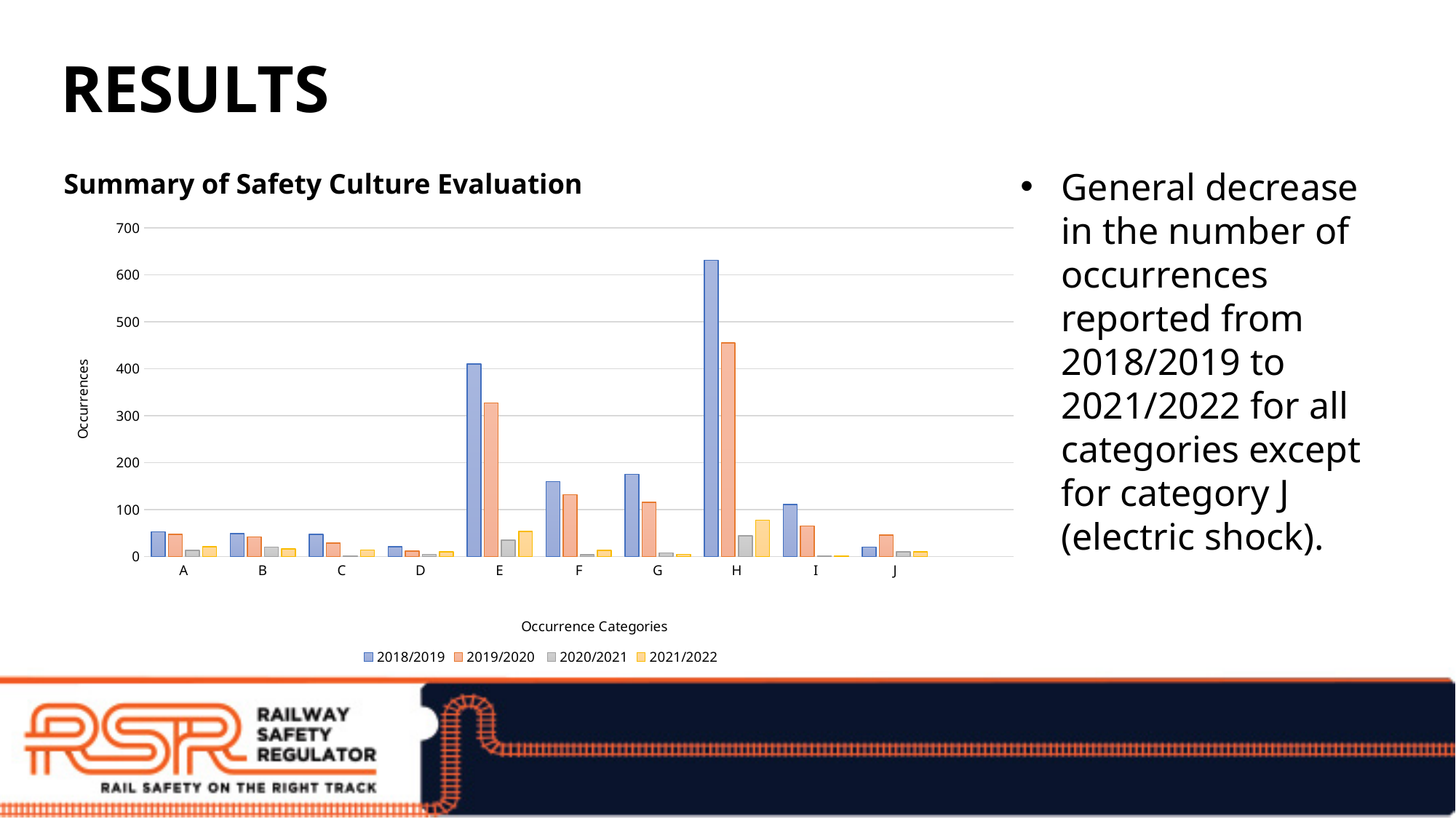
How many occurrence categories are shown on the x axis of the chart? 10 Which occurrence category has the highest value for 2021/2022? H In category J, which series has the larger value, 2018/2019 or 2019/2020? 2019/2020 Is the 2018/2019 value for category H greater or less than 600? greater Is the 2019/2020 value for category G greater or less than 200? less Is the 2018/2019 value for category E greater or less than 300? greater In category E, which series has the larger value, 2018/2019 or 2019/2020? 2018/2019 Which occurrence category has the highest value for 2018/2019? H What is the title of the chart's vertical axis? Occurrences What kind of chart is shown on the slide? bar chart How many series does the chart's legend list? 4